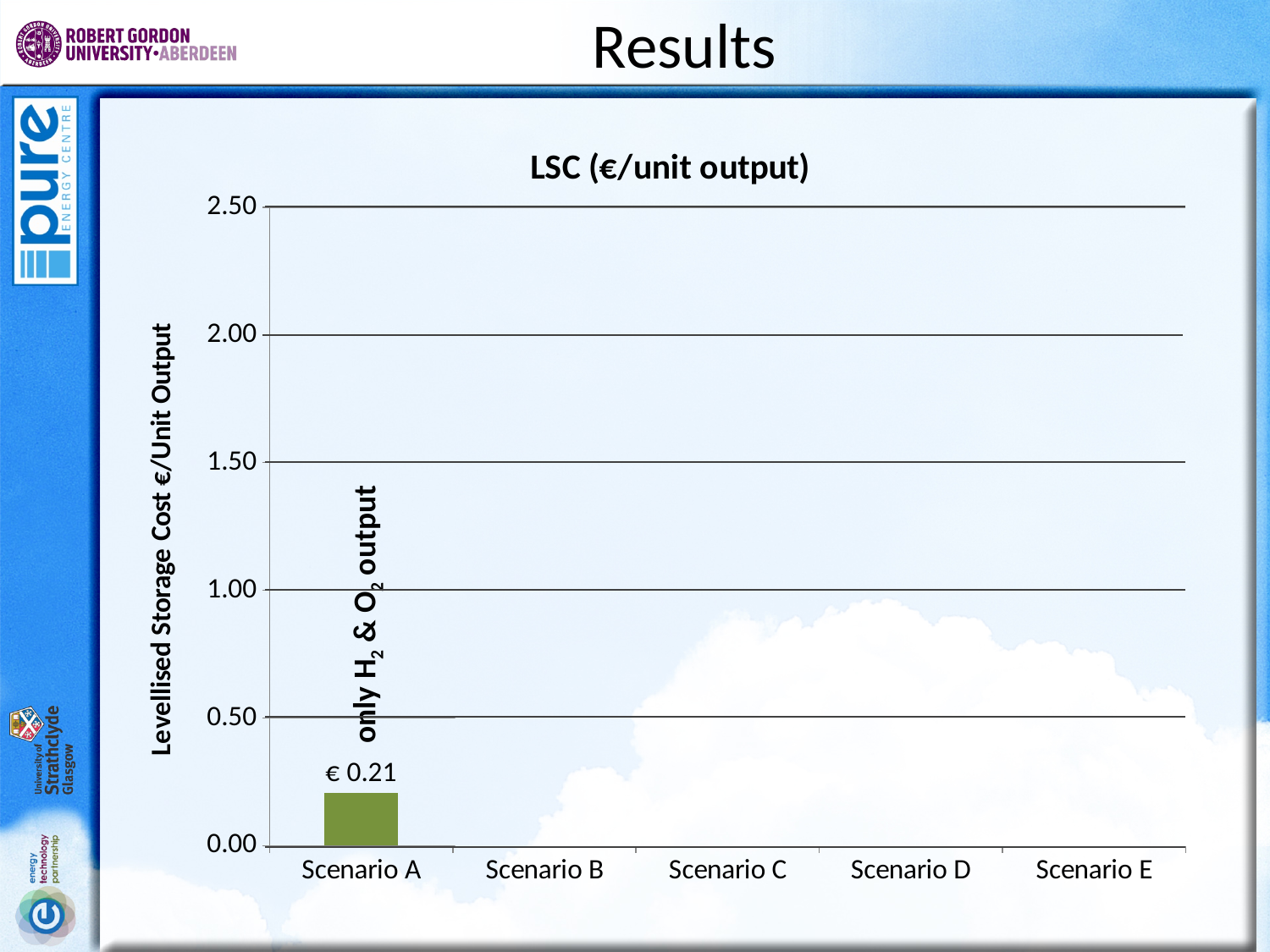
How many scenario categories are labelled on the x axis of the chart? 5 What is the value for Scenario A in the LSC (€/unit output) chart? € 0.21 What kind of chart is shown on the slide? bar chart What is the highest value shown on the y axis of the chart? 2.50 What is the y-axis label of the chart? Levellised Storage Cost €/Unit Output What is the title of the chart? LSC (€/unit output) Is the value for Scenario A greater or less than 0.50? less What annotation is written above the Scenario A bar? only H2 & O2 output What is the label of the last category on the x axis? Scenario E Is the value for Scenario A greater or less than 1.00? less Which scenario is the only one with a bar plotted in the chart? Scenario A